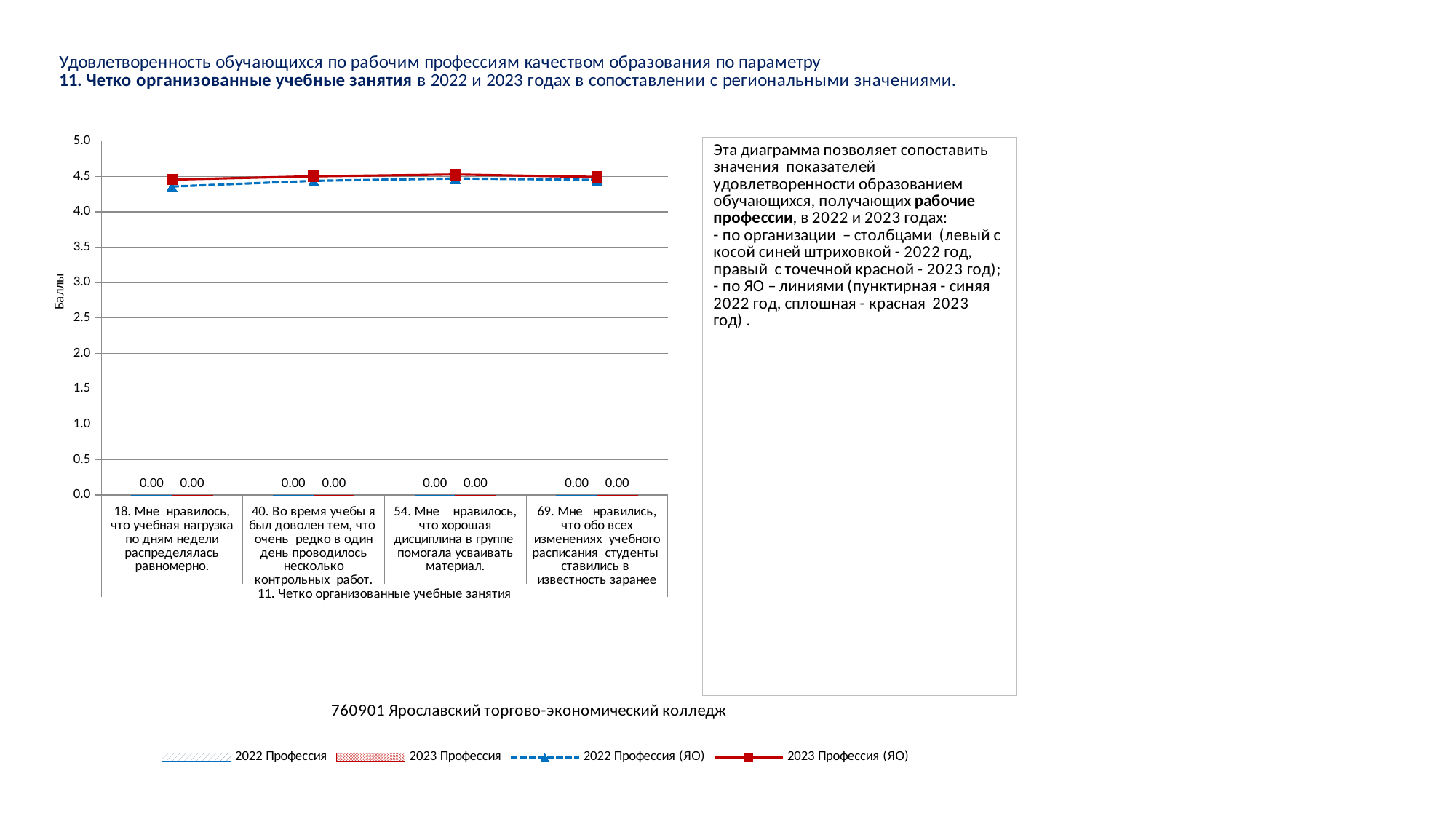
What is the value of the 2023 Профессия bar for category 69 (Мне нравились, что обо всех изменениях учебного расписания студенты ставились в известность заранее)? 0.00 Is the value of the 2022 Профессия (ЯО) line for category 69 greater or less than 4.0? greater What is the value of the 2023 Профессия bar for category 54 (Мне нравилось, что хорошая дисциплина в группе помогала усваивать материал)? 0.00 How many categories (questions) are shown on the x axis of the chart? 4 What is the title shown below the chart? 760901 Ярославский торгово-экономический колледж What kind of chart is shown on the slide? Combined bar and line chart What is the label of the vertical axis of the chart? Баллы How many series does the chart legend list? 4 What is the value of the 2022 Профессия bar for category 18 (Мне нравилось, что учебная нагрузка по дням недели распределялась равномерно)? 0.00 Is the value of the 2022 Профессия (ЯО) line for category 18 greater or less than 5.0? less What is the value of the 2022 Профессия bar for category 40 (Во время учебы я был доволен тем, что очень редко в один день проводилось несколько контрольных работ)? 0.00 Is the value of the 2023 Профессия (ЯО) line for category 40 greater or less than 4.0? greater